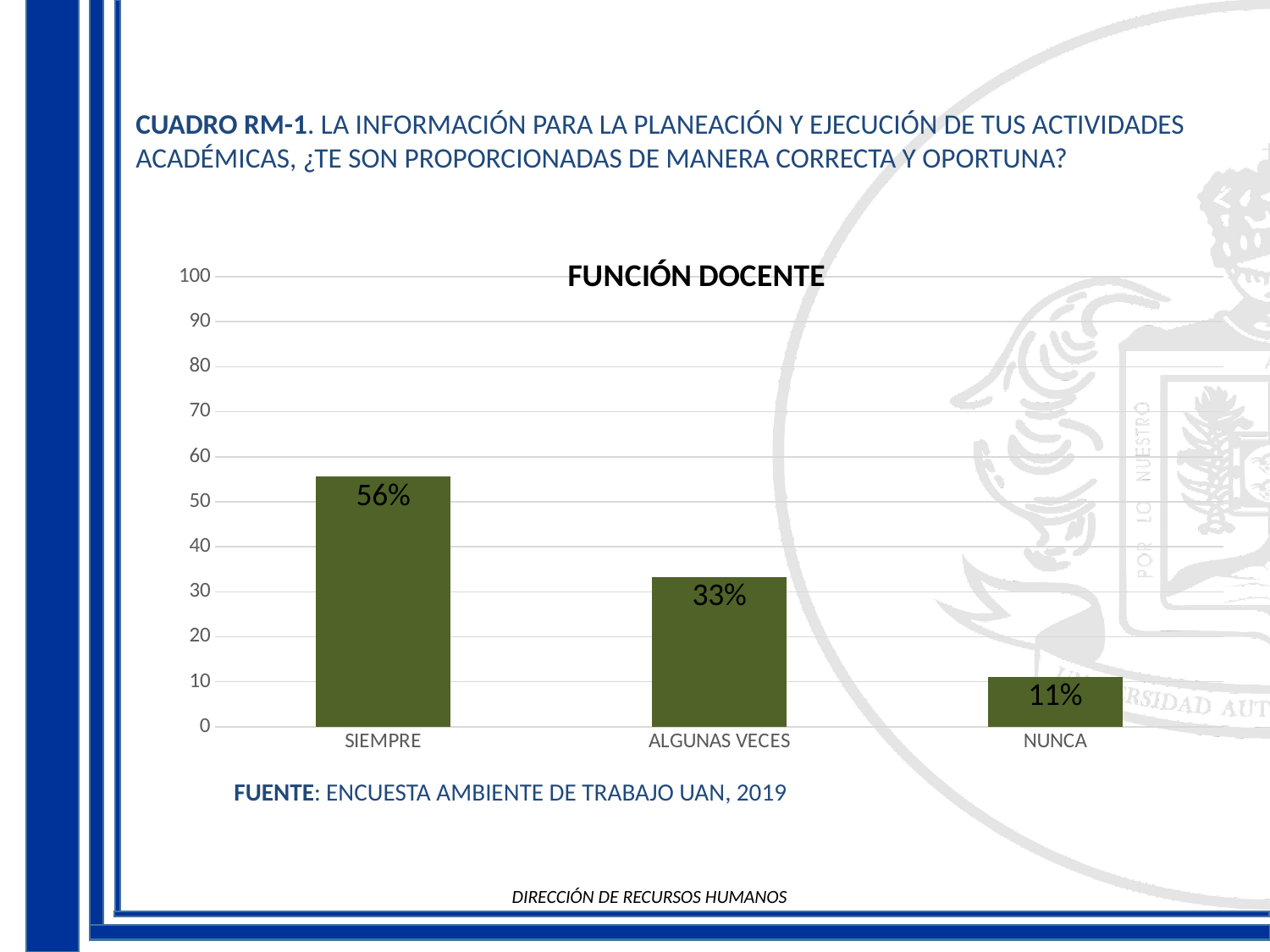
Which category has the highest value? SIEMPRE What is the value for NUNCA? 11% What is the value for SIEMPRE? 56% Is the value for SIEMPRE greater or less than 50? greater What is the title of the chart? FUNCIÓN DOCENTE What is the difference between the values for SIEMPRE and ALGUNAS VECES? 23% Which category has the lowest value? NUNCA Which is larger, the value for ALGUNAS VECES or the value for NUNCA? ALGUNAS VECES What kind of chart is shown on the slide? bar chart What is the difference between the values for ALGUNAS VECES and NUNCA? 22% What is the value for ALGUNAS VECES? 33% How many categories are shown on the x axis? 3